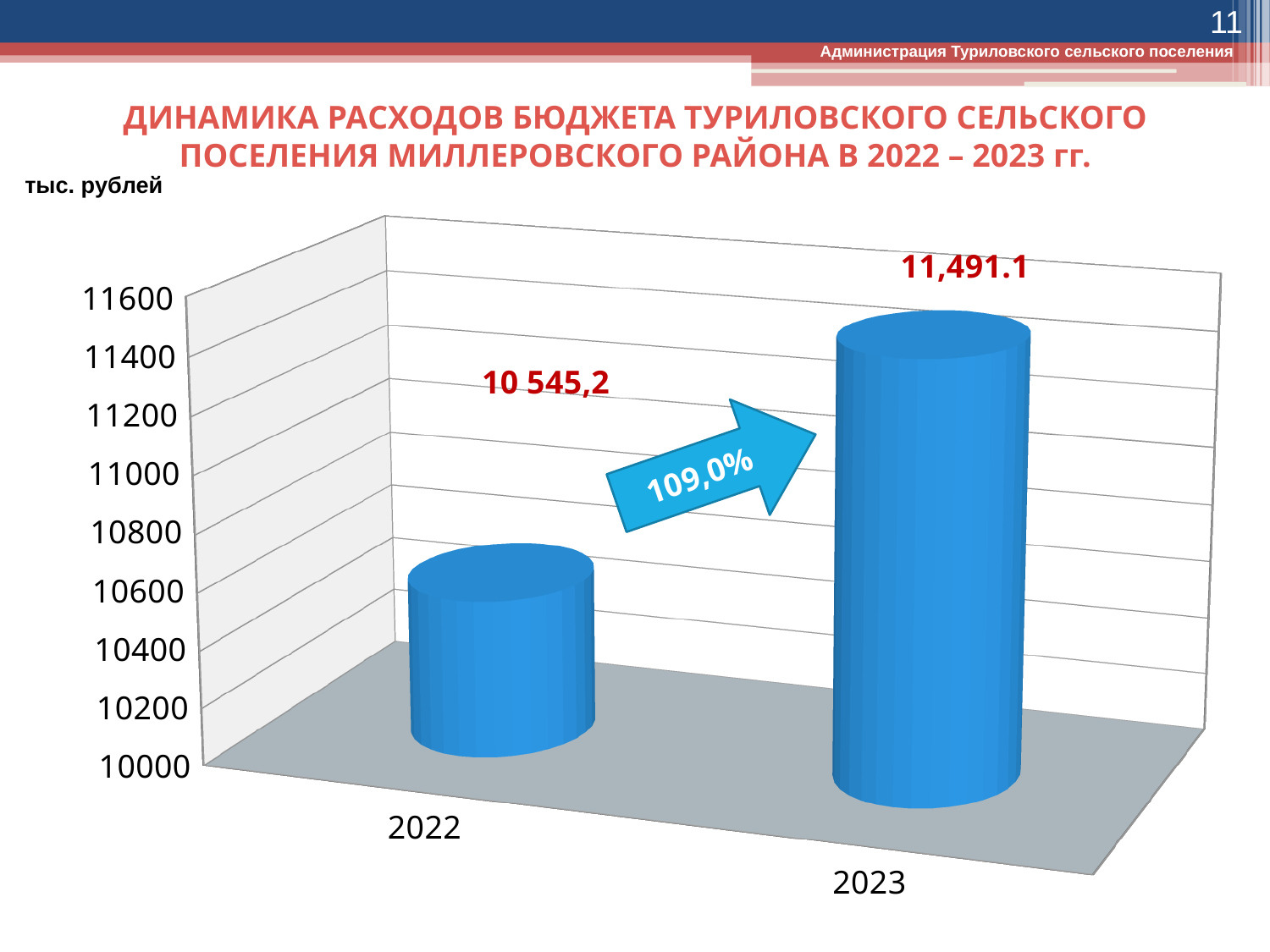
What is the value for 2022? 10 545,2 How many years are shown on the chart? 2 Which is larger, the value for 2022 or the value for 2023? 2023 What kind of chart is shown on the slide? bar chart Which year has the highest value? 2023 In what units are the values on the chart expressed? тыс. рублей What is the value for 2023? 11,491.1 Which year has the lowest value? 2022 Do the values rise or fall from 2022 to 2023? rise Is the value for 2022 greater or less than 10400? greater Is the value for 2023 greater or less than 11600? less What percentage is written on the arrow between the two bars? 109,0%